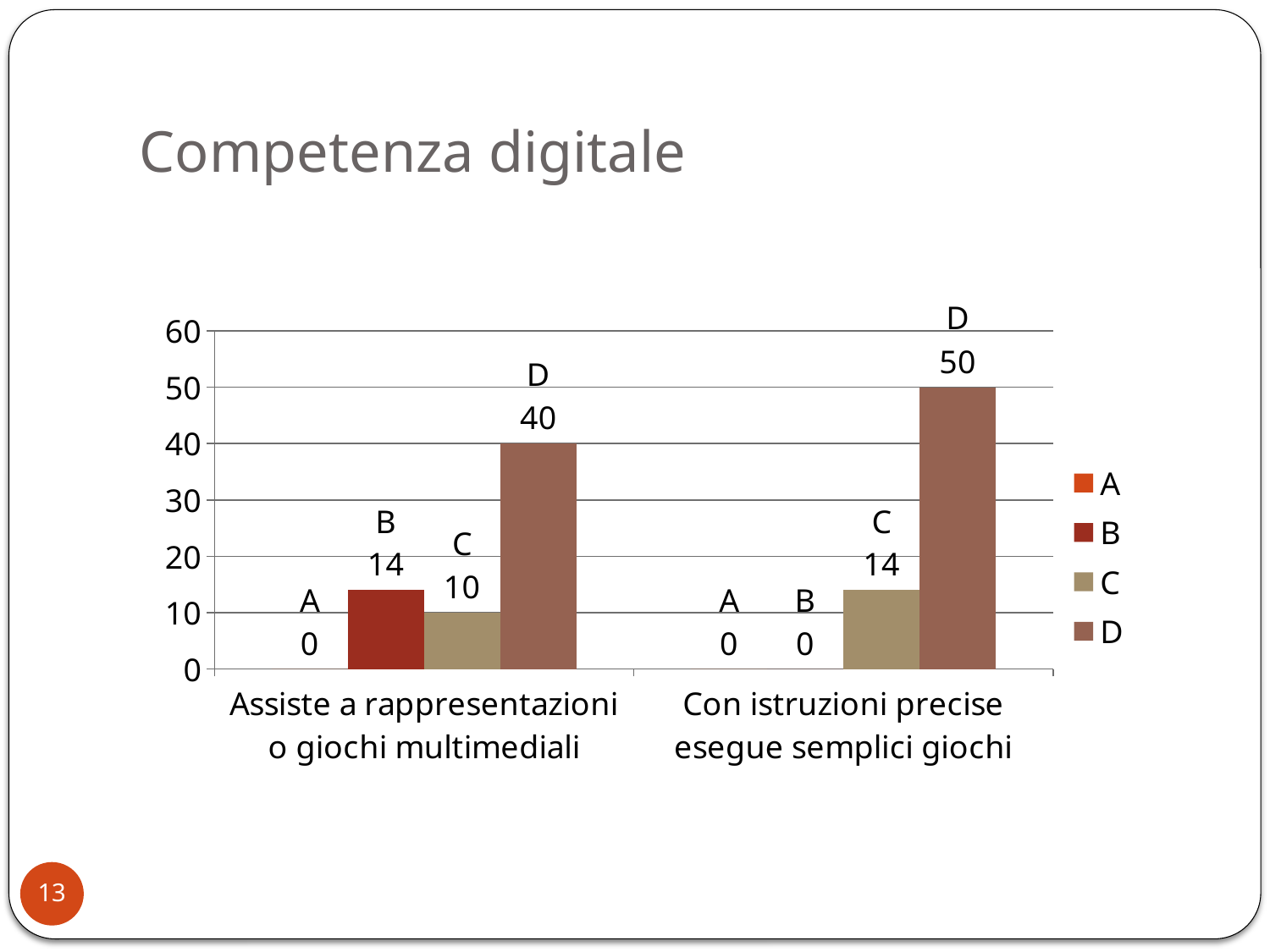
How many categories are shown on the x axis? 2 Is the value for D in "Con istruzioni precise esegue semplici giochi" greater or less than 30? greater What is the value for series C in the category "Con istruzioni precise esegue semplici giochi"? 14 What is the value for series D in the category "Assiste a rappresentazioni o giochi multimediali"? 40 Which is larger in the category "Assiste a rappresentazioni o giochi multimediali": the value for B or the value for C? B What is the difference between the D values of the two categories? 10 What is the difference between the C values of the two categories? 4 What is the value for series B in the category "Assiste a rappresentazioni o giochi multimediali"? 14 What kind of chart is shown on the slide? bar chart How many series does the legend list? 4 What is the title of the slide? Competenza digitale Which series has the highest value in the category "Con istruzioni precise esegue semplici giochi"? D